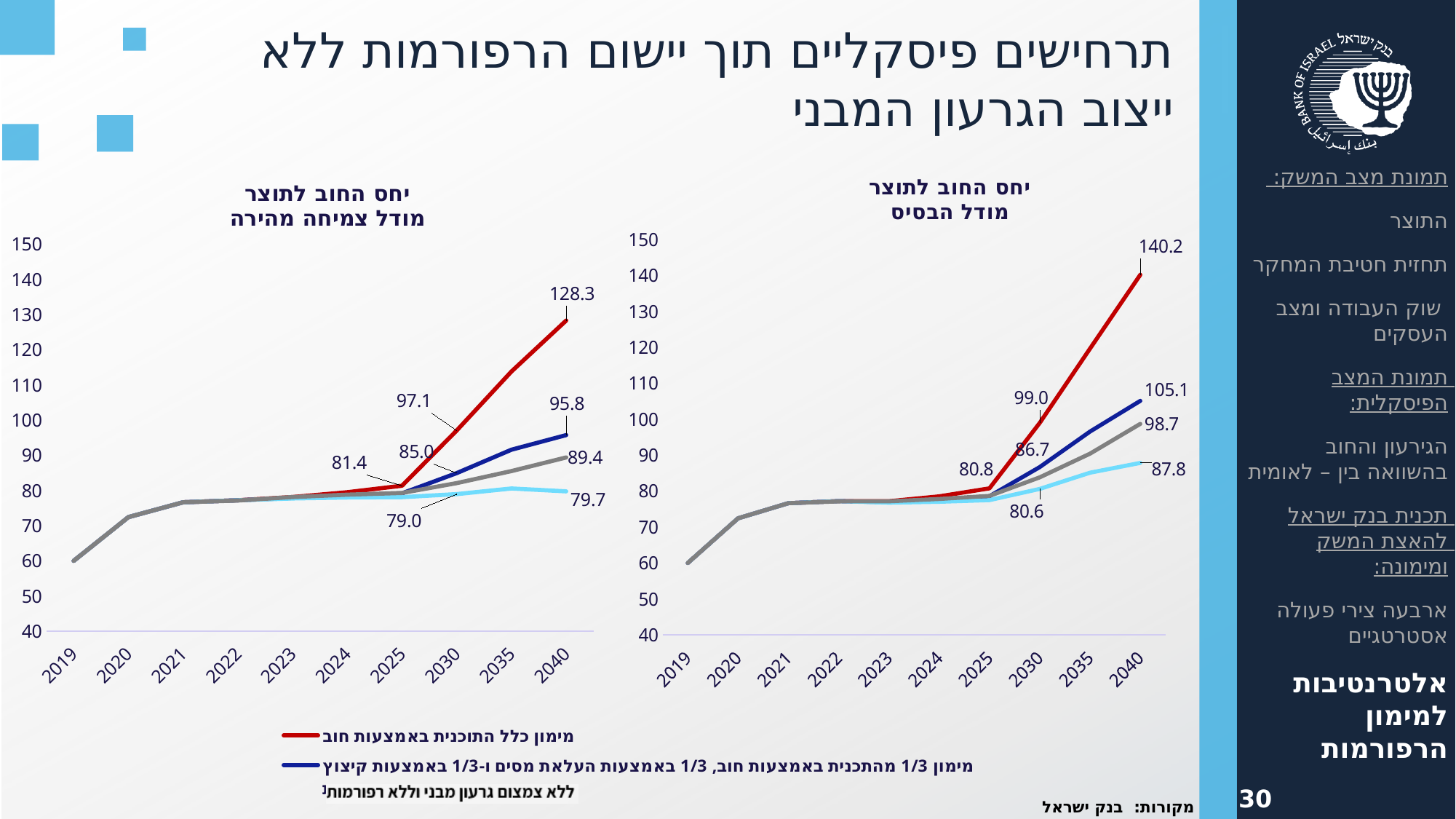
In the right chart (יחס החוב לתוצר מודל הבסיס), what is the 2040 value of the red line (מימון כלל התוכנית באמצעות חוב)? 140.2 How many years are shown on the x axis of each chart? 10 In the left chart (מודל צמיחה מהירה), what is the difference between the 2040 values of the red line (128.3) and the dark blue line (95.8)? 32.5 In the left chart (מודל צמיחה מהירה), is the 2035 value of the red line greater or less than 100? greater In the left chart (מודל צמיחה מהירה), what is the 2040 value of the dark blue line (מימון 1/3 מהתכנית באמצעות חוב)? 95.8 What type of chart is used on this slide? Line chart In the right chart (מודל הבסיס), what is the 2040 value of the grey line (ללא צמצום גרעון מבני וללא רפורמות)? 98.7 In the right chart (מודל הבסיס), does the red line rise or fall between 2025 and 2040? Rises In the right chart (מודל הבסיס), what is the 2030 value of the red line? 99.0 Comparing the 2040 values of the red line in both charts, which chart shows the larger value? The right chart (מודל הבסיס), 140.2 In the right chart (מודל הבסיס), which series has the highest value in 2040? מימון כלל התוכנית באמצעות חוב (red line) In the left chart (יחס החוב לתוצר מודל צמיחה מהירה), what is the 2040 value of the red line (מימון כלל התוכנית באמצעות חוב)? 128.3